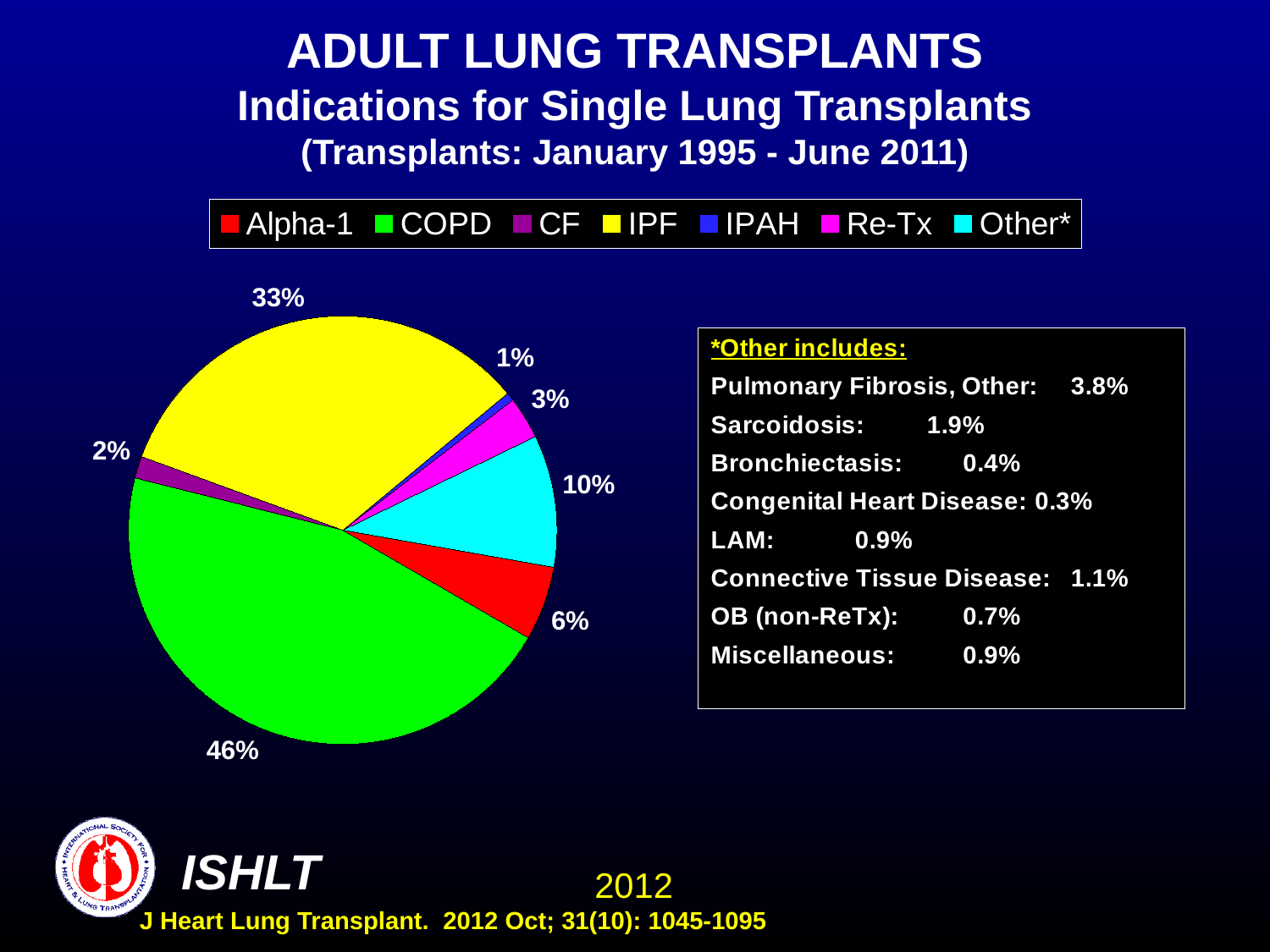
What share of single lung transplants is for IPF? 33% How many indications does the legend list? 7 What percentage of the pie is IPAH? 1% What colour represents COPD in the pie chart? green What is the difference in percentage points between COPD and IPF? 13 Which indication has the largest share of single lung transplants? COPD What percentage of the pie is Other*? 10% What percentage of the pie is Alpha-1? 6% Which is larger, the share for Re-Tx or the share for CF? Re-Tx What share of single lung transplants is for COPD? 46% What type of chart is shown on the slide? pie chart Which indication has the smallest share of single lung transplants? IPAH